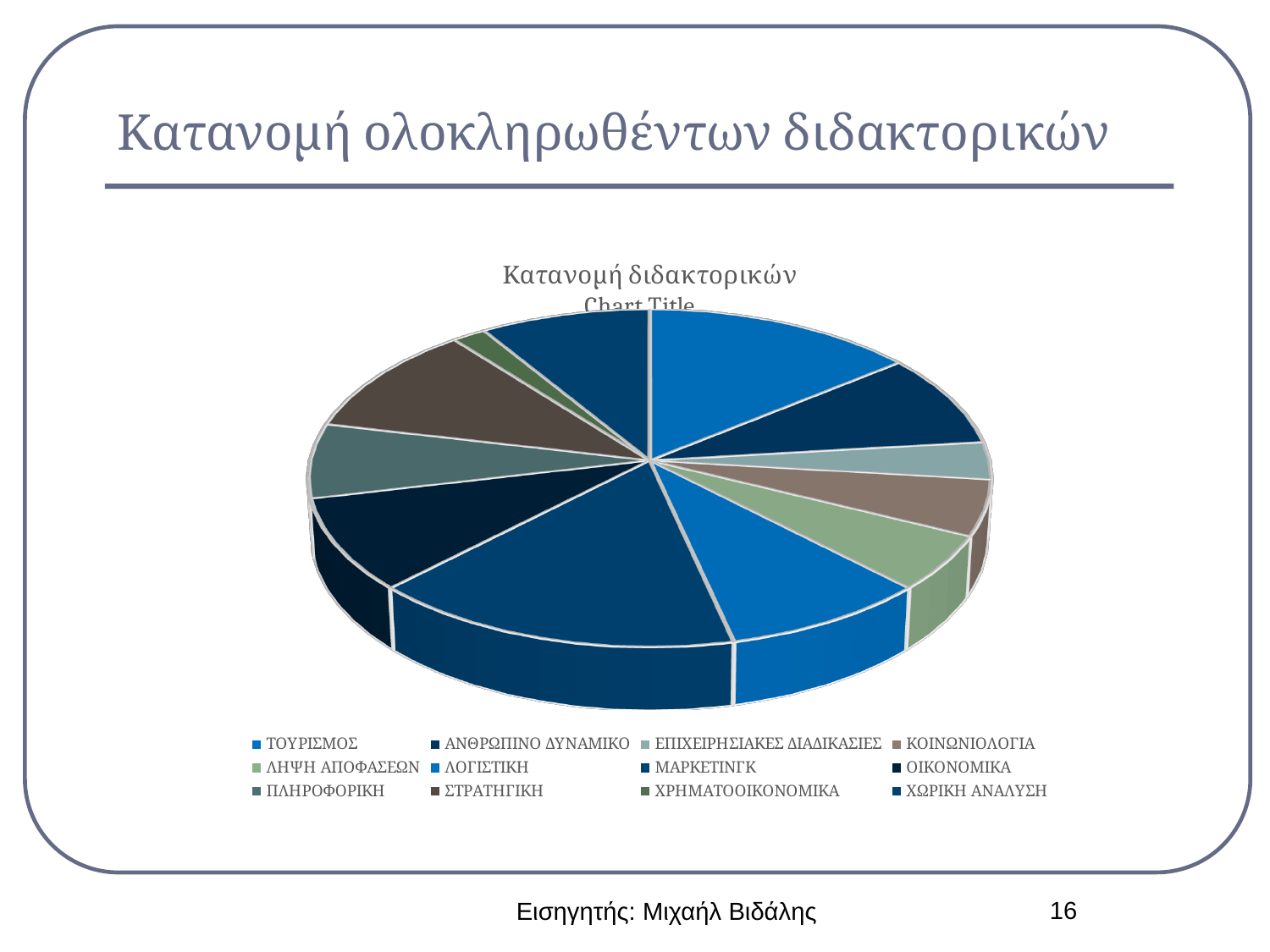
Which slice is larger, ΜΑΡΚΕΤΙΝΓΚ or ΧΡΗΜΑΤΟΟΙΚΟΝΟΜΙΚΑ? ΜΑΡΚΕΤΙΝΓΚ What kind of chart is shown on the slide? Pie chart What is the title of the chart? Κατανομή διδακτορικών Which legend entry is listed first in the pie chart's legend? ΤΟΥΡΙΣΜΟΣ Which category has the smallest slice in the pie chart? ΧΡΗΜΑΤΟΟΙΚΟΝΟΜΙΚΑ How many categories does the pie chart's legend list? 12 Does the pie chart display data labels with the values of the slices? No Which slice is larger, ΤΟΥΡΙΣΜΟΣ or ΧΡΗΜΑΤΟΟΙΚΟΝΟΜΙΚΑ? ΤΟΥΡΙΣΜΟΣ